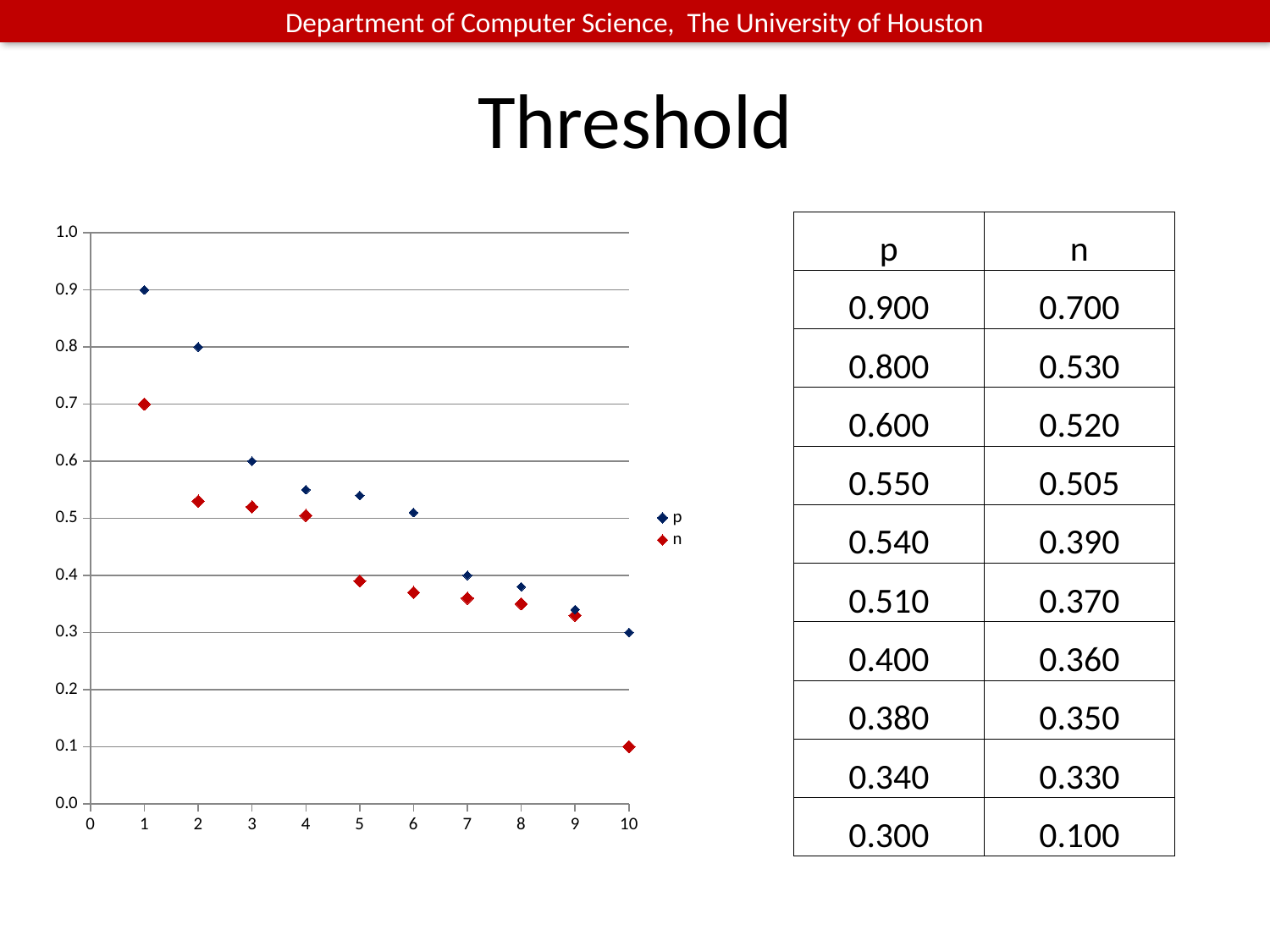
Is the value of n at x = 5 greater or less than 0.4? less What is the value of p at x = 7? 0.4 What are the names of the two series in the chart legend? p and n What is the value of p at x = 1? 0.9 At which x value is the p series highest? 1 At x = 3, which series has the larger value, p or n? p What kind of chart is shown on the slide? scatter chart What is the value of n at x = 10? 0.1 Do the p values rise or fall as x increases from 1 to 10? fall How many series does the chart legend list? 2 At which x value is the n series lowest? 10 How many points are plotted for the p series? 10